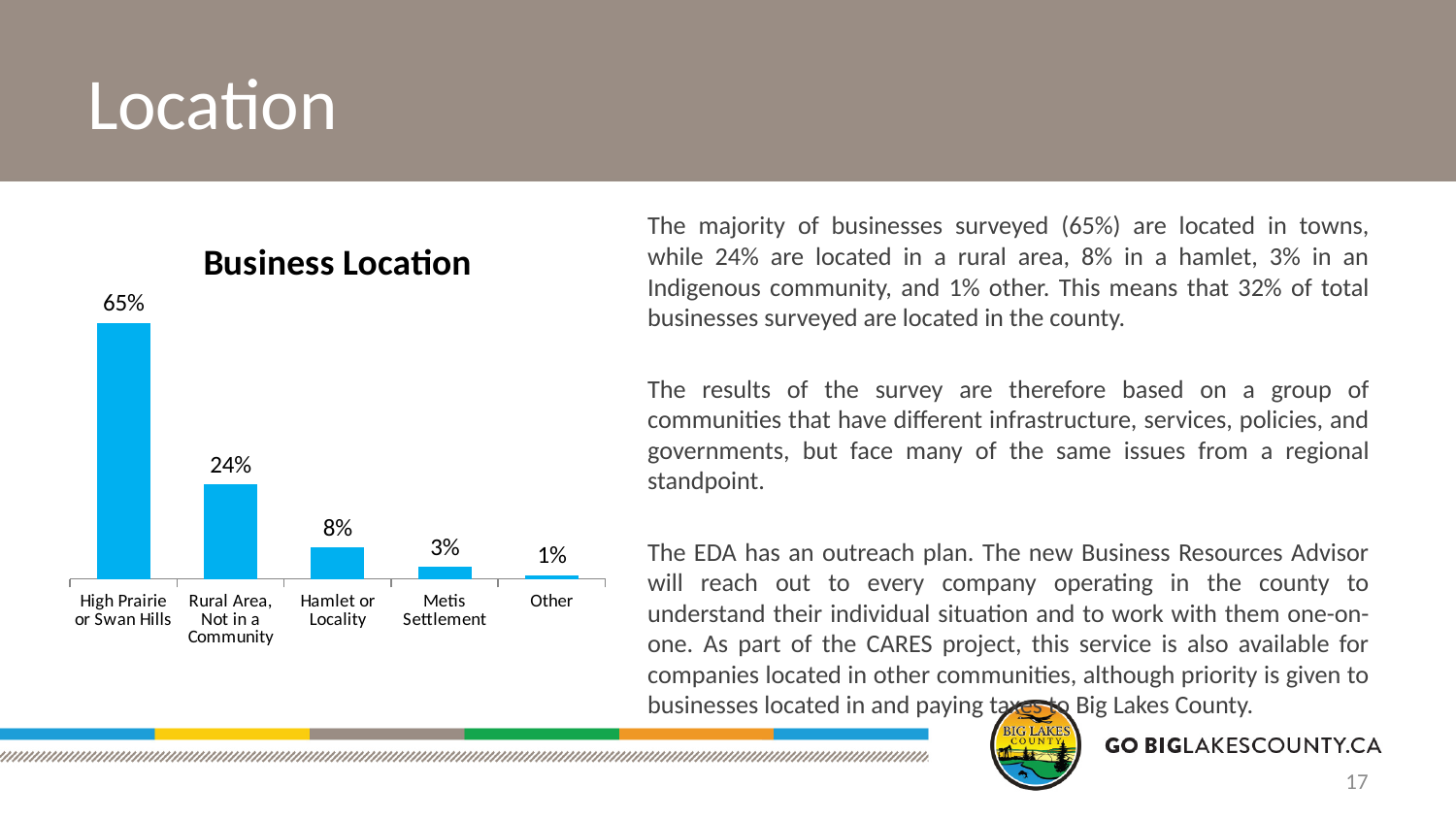
Which is larger in the Business Location chart: Hamlet or Locality or Metis Settlement? Hamlet or Locality Which category has the highest value in the Business Location chart? High Prairie or Swan Hills What is the difference between the values for High Prairie or Swan Hills and Rural Area, Not in a Community? 41% What is the value for Hamlet or Locality in the Business Location chart? 8% What kind of chart is the Business Location chart? Bar chart What is the value for Other in the Business Location chart? 1% What is the value for High Prairie or Swan Hills in the Business Location chart? 65% How many categories are shown in the Business Location chart? 5 What is the value for Rural Area, Not in a Community in the Business Location chart? 24% What is the title of the chart on the slide? Business Location Which category has the lowest value in the Business Location chart? Other What is the value for Metis Settlement in the Business Location chart? 3%